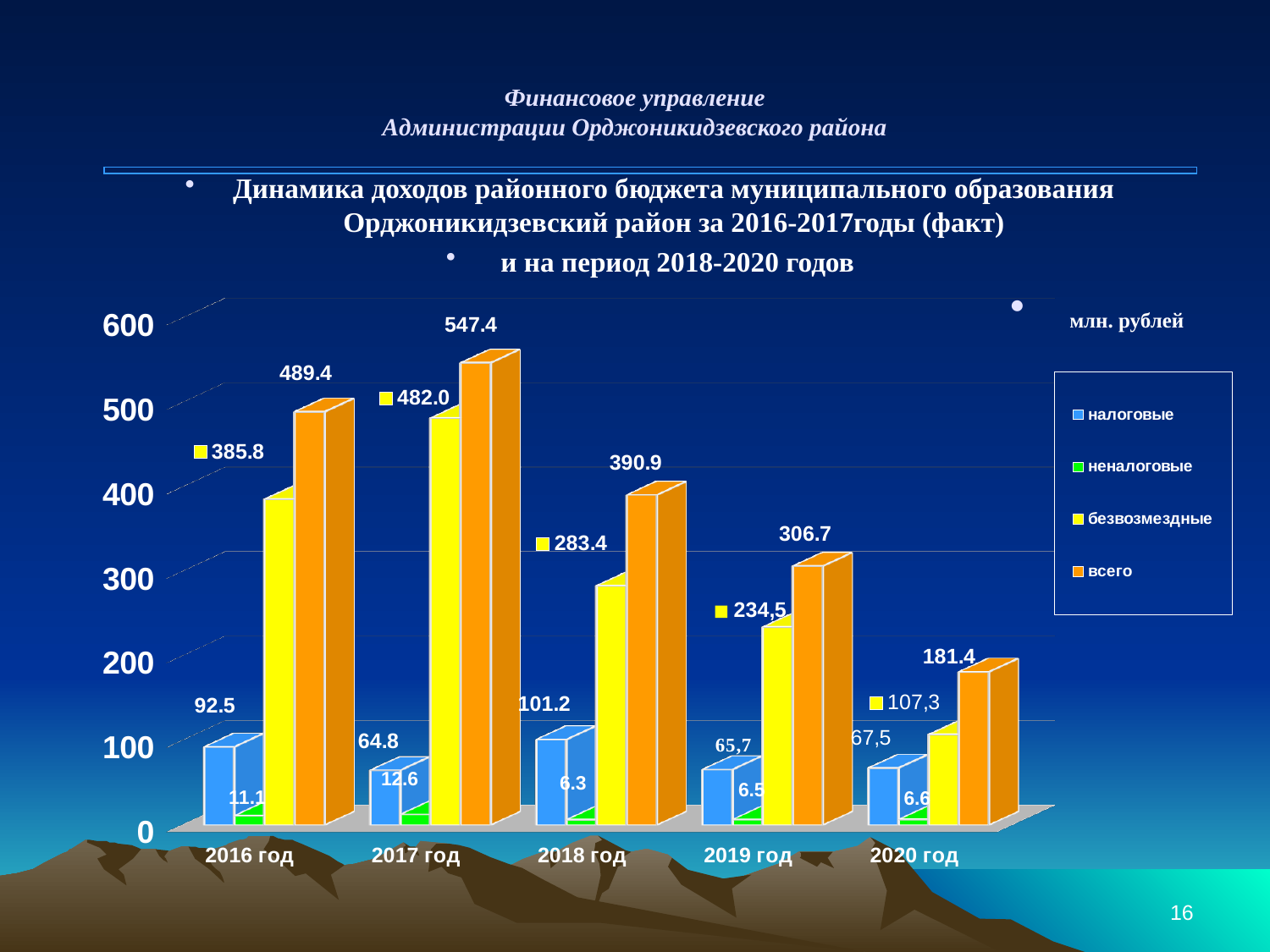
Does всего rise or fall from 2017 год to 2020 год? fall What is the value of налоговые for 2018 год? 101.2 In which year is всего the highest? 2017 год What is the value of безвозмездные for 2019 год? 234,5 Which is larger: безвозмездные for 2018 год or безвозмездные for 2019 год? 2018 год What is the difference between всего for 2017 год and всего for 2016 год? 58.0 How many series does the legend list? 4 What is the value of всего for 2017 год? 547.4 What is the value of неналоговые for 2016 год? 11.1 How many year categories are shown on the x axis? 5 In which year is всего the lowest? 2020 год What type of chart is shown on the slide? bar chart